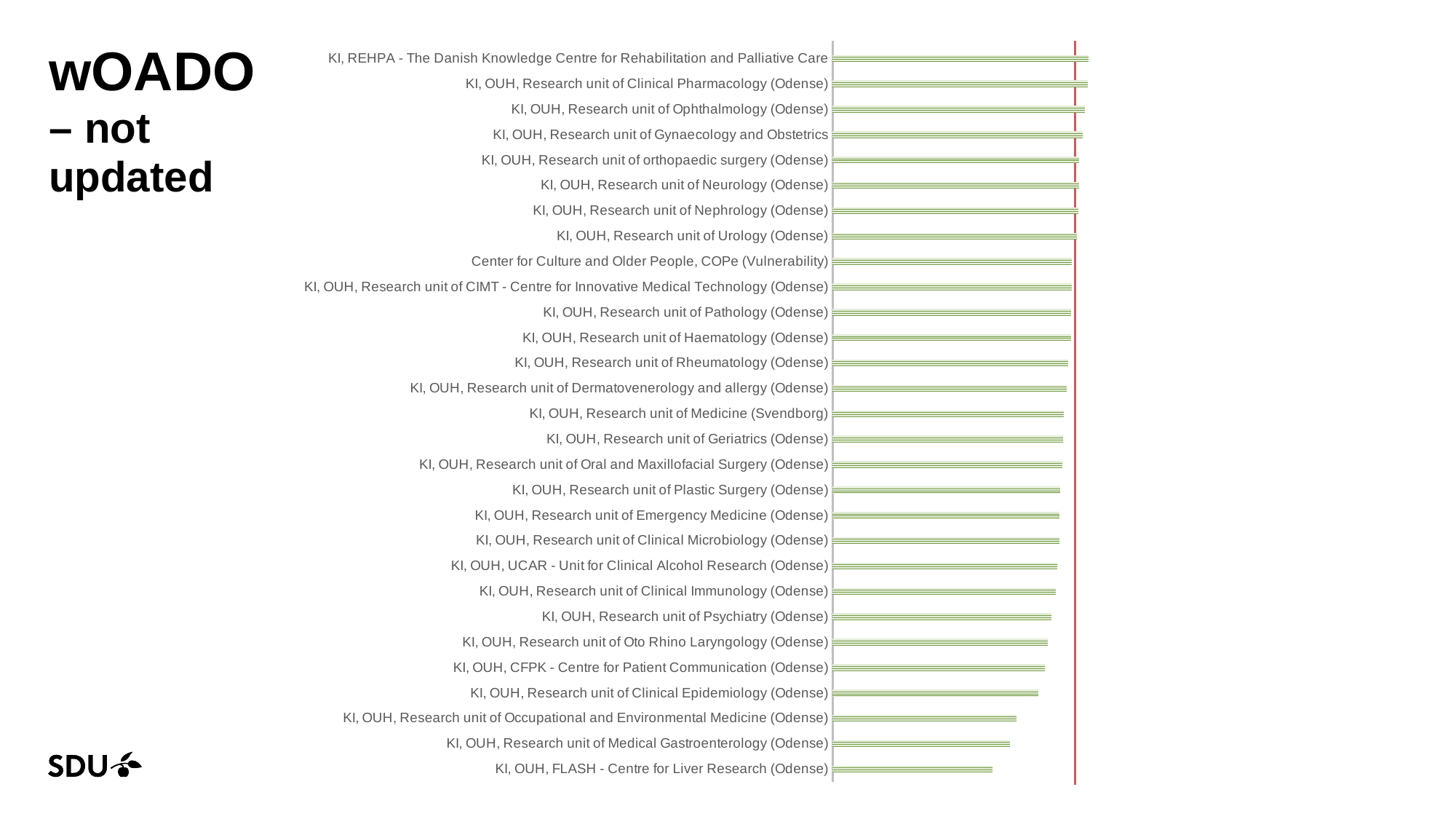
Which has the longer bar: KI, REHPA - The Danish Knowledge Centre for Rehabilitation and Palliative Care or KI, OUH, FLASH - Centre for Liver Research (Odense)? KI, REHPA - The Danish Knowledge Centre for Rehabilitation and Palliative Care Which has the longer bar: KI, OUH, FLASH - Centre for Liver Research (Odense) or KI, OUH, Research unit of Medical Gastroenterology (Odense)? KI, OUH, Research unit of Medical Gastroenterology (Odense) How many research units (categories) are listed in the chart? 29 Do the bar lengths increase or decrease going from the top of the chart to the bottom? decrease Which has the longer bar: KI, OUH, Research unit of Clinical Epidemiology (Odense) or KI, OUH, Research unit of Occupational and Environmental Medicine (Odense)? KI, OUH, Research unit of Clinical Epidemiology (Odense) What kind of chart is shown on the slide? bar chart Which research unit has the shortest bar in the chart? KI, OUH, FLASH - Centre for Liver Research (Odense) Which category is listed at the top of the chart? KI, REHPA - The Danish Knowledge Centre for Rehabilitation and Palliative Care What is the title text shown on the slide next to the chart? wOADO – not updated